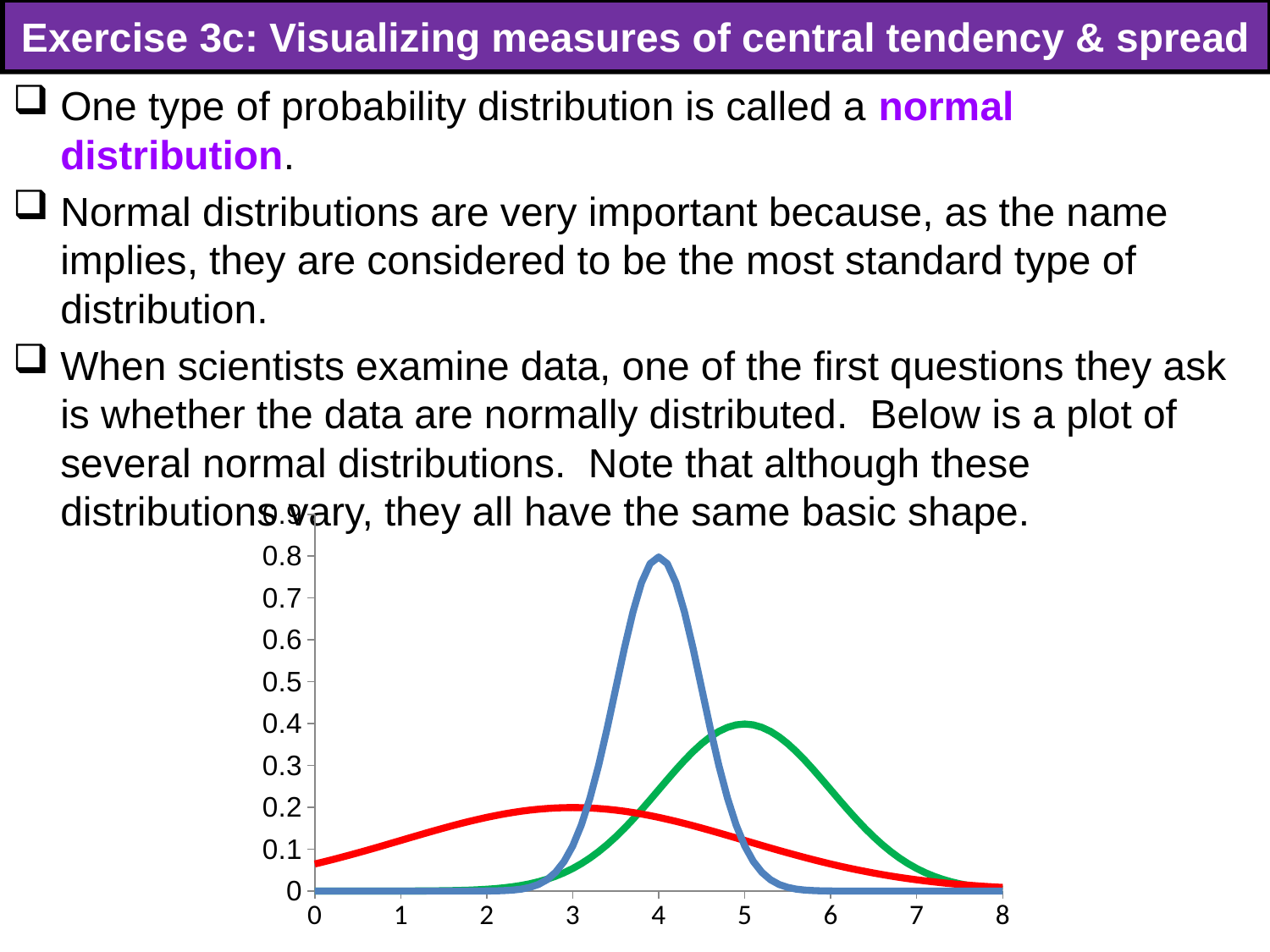
At what x value does the blue curve reach its peak? 4 At what x value does the green curve reach its peak? 5 Which curve has a higher peak, the blue curve or the green curve? the blue curve Which curve has the lowest peak on the chart? the red curve Is the peak of the red curve greater or less than 0.1? greater What is the largest value shown on the x axis of the chart? 8 How many curves are plotted on the chart? 3 At what x value does the red curve reach its peak? 3 Is the peak of the green curve greater or less than 0.5? less Which curve reaches the highest peak on the chart? the blue curve What kind of chart is shown on the slide? line chart Is the peak of the blue curve greater or less than 0.7? greater